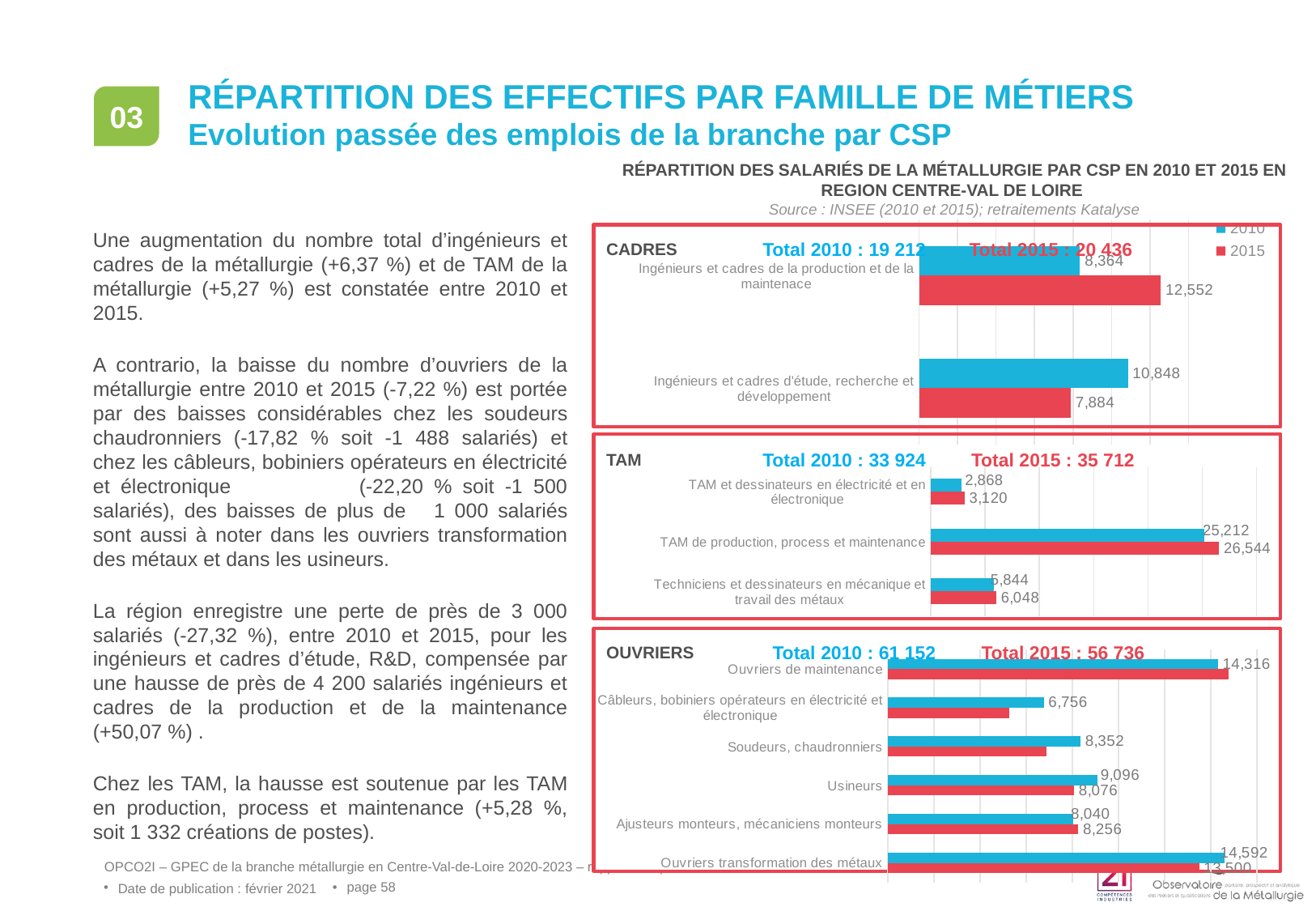
In the TAM chart, what is the difference between the 2015 and 2010 values for TAM de production, process et maintenance? 1,332 In the OUVRIERS chart, what is the 2010 value for Usineurs? 9,096 In the CADRES chart, what is the 2015 value for Ingénieurs et cadres de la production et de la maintenance? 12,552 In the OUVRIERS chart, how many categories are shown? 6 In the CADRES chart, which category and year has the lowest value? Ingénieurs et cadres d'étude, recherche et développement, 2015 In the CADRES chart, what is the 2010 value for Ingénieurs et cadres d'étude, recherche et développement? 10,848 In the TAM chart, how many categories are shown? 3 How many series does the legend list for the charts? 2 In the TAM chart, what is the 2015 value for TAM de production, process et maintenance? 26,544 In the OUVRIERS chart, is the 2010 or the 2015 value larger for Usineurs? 2010 In the TAM chart, which category has the highest 2010 value? TAM de production, process et maintenance In the CADRES chart, what is the difference between the 2015 and 2010 values for Ingénieurs et cadres de la production et de la maintenance? 4,188